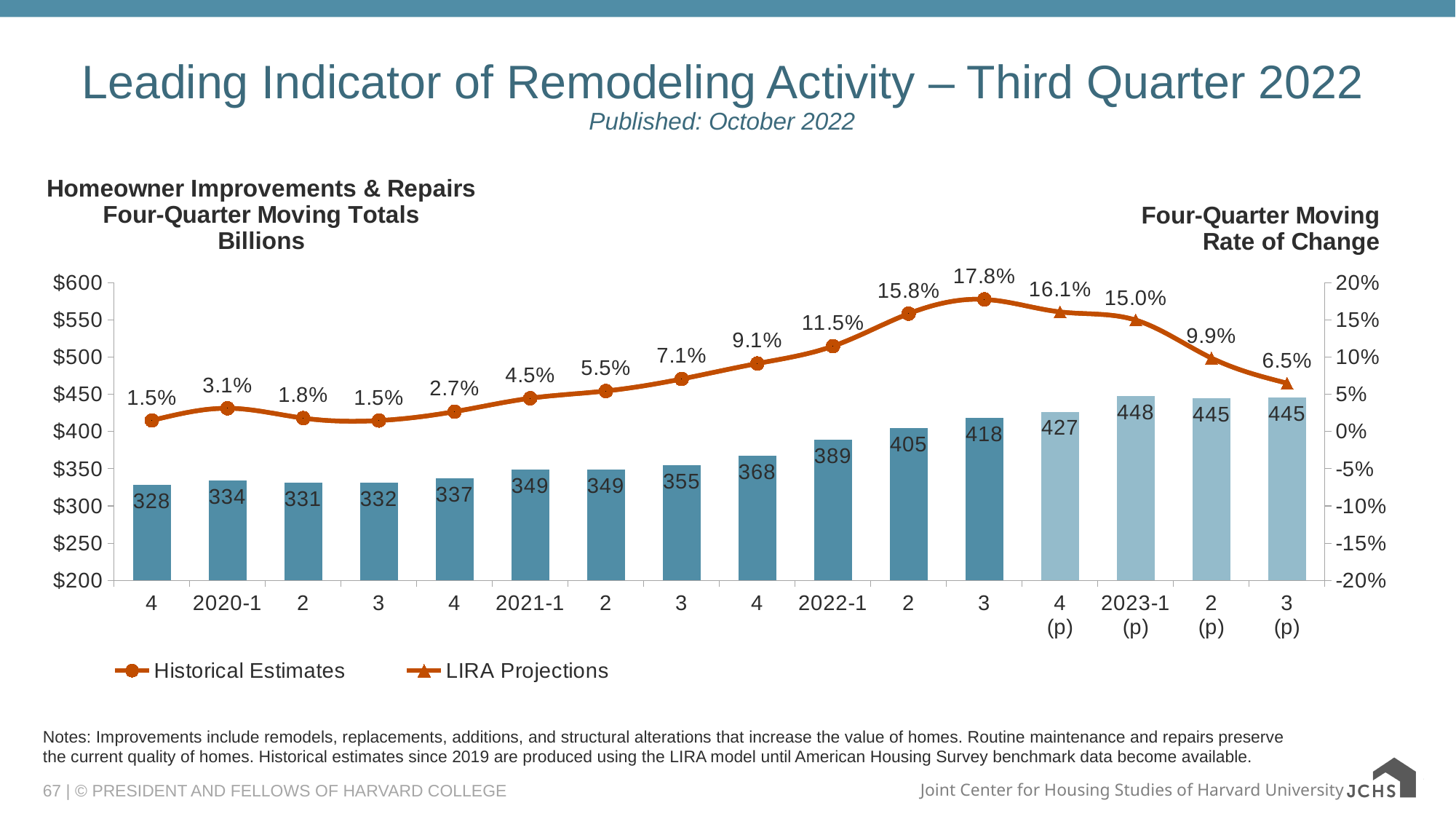
Does the four-quarter moving rate of change rise or fall from 2022-3 to 2023-3 (p)? Fall Which quarter has the highest four-quarter moving total bar? 2023-1 (p) at 448 What is the lowest four-quarter moving total shown on the bars? 328 What is the projected four-quarter moving rate of change for 2023-3 (p)? 6.5% What is the four-quarter moving rate of change for 2022-2? 15.8% Which has the larger four-quarter moving total, 2021-4 or 2022-1? 2022-1 What kind of chart is shown on the slide? Combination bar and line chart How many bars (quarters) are plotted in the chart? 16 How much higher is the four-quarter moving total for 2023-1 (p) than for 2022-3? 30 Which quarter has the highest four-quarter moving rate of change? 2022-3 (17.8%) What is the four-quarter moving total (in billions) for 2022-3? 418 How many series does the legend list? 2